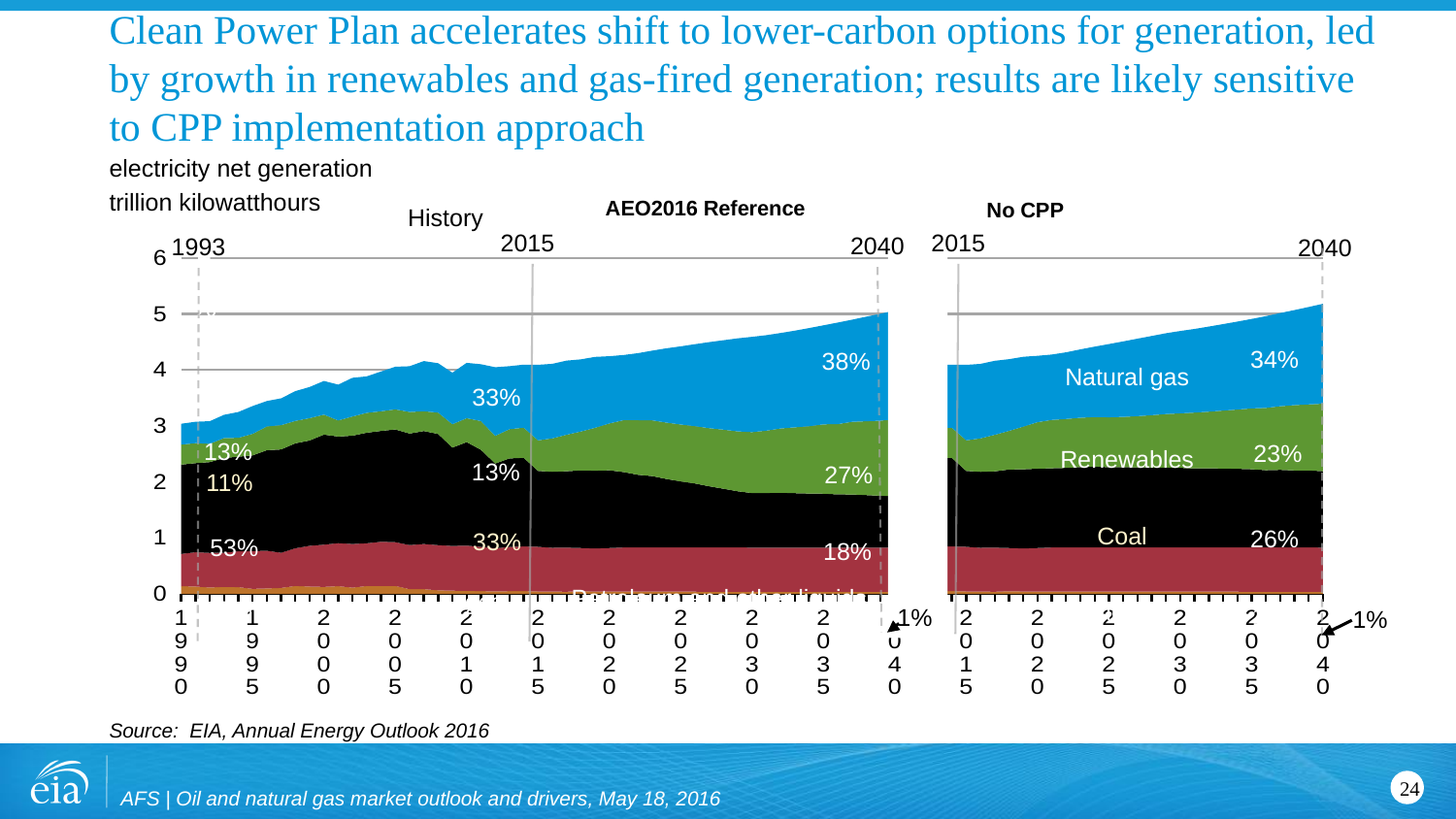
In the AEO2016 Reference chart, is total electricity net generation in 2040 greater or less than 4 trillion kilowatthours? greater In the AEO2016 Reference chart, does total electricity net generation rise or fall from 2015 to 2040? Rise In the AEO2016 Reference chart, what is the renewables share of generation in 2040? 27% Which chart shows a larger renewables share in 2040, AEO2016 Reference or No CPP? AEO2016 Reference In the left chart, what was the natural gas share of generation in 2015? 33% In the AEO2016 Reference chart, what share of electricity net generation does natural gas account for in 2040? 38% What kind of chart is used on this slide to show electricity net generation? Stacked area chart In the History portion of the left chart, what share of generation did coal account for in 1993? 53% What unit is used on the y axis of the charts? trillion kilowatthours By how many percentage points does the 2040 coal share in the No CPP chart exceed the 2040 coal share in the AEO2016 Reference chart? 8 percentage points In the No CPP chart, what share of electricity net generation does coal account for in 2040? 26% In the No CPP chart, what is the natural gas share of generation in 2040? 34%